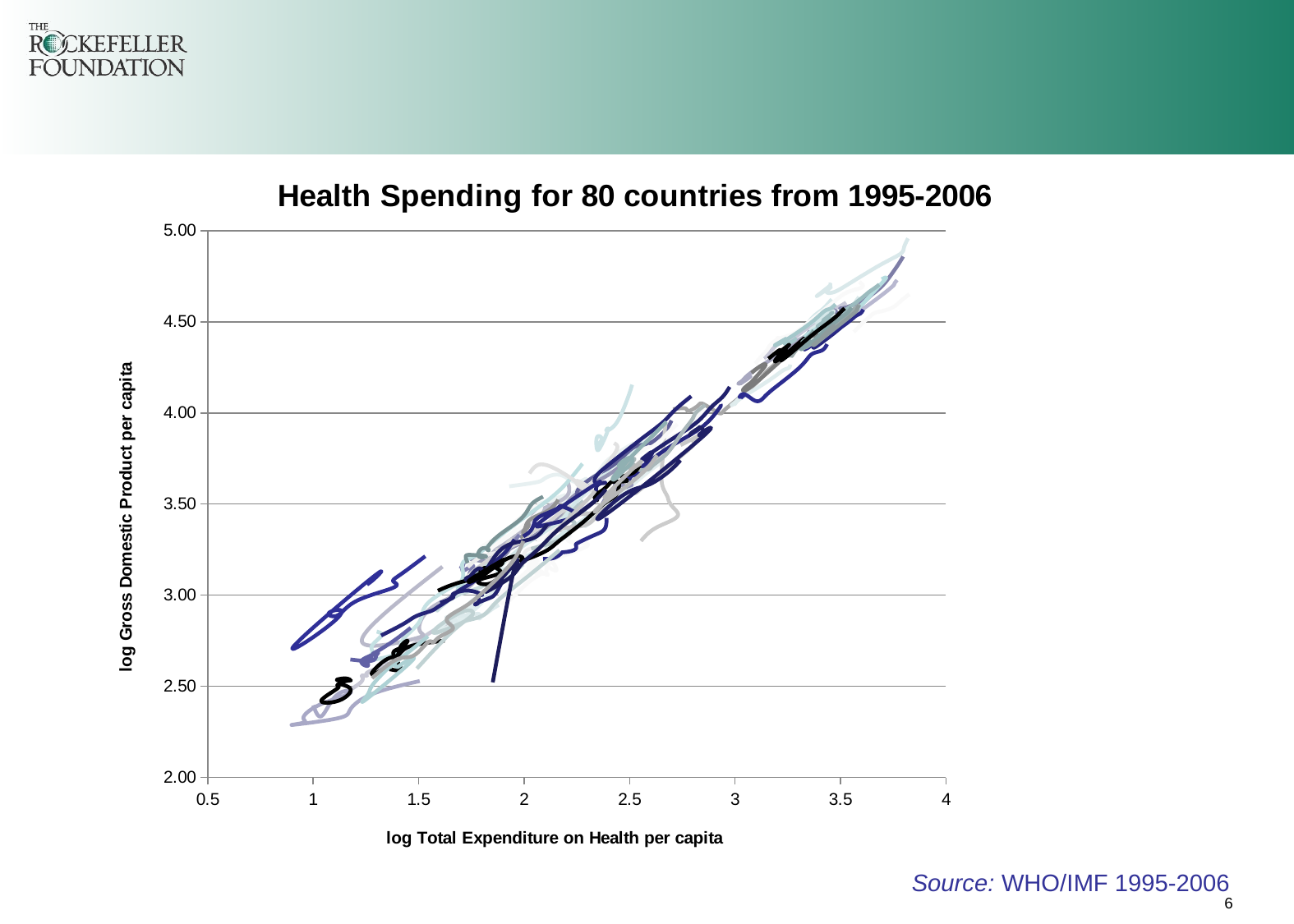
What is the lowest value shown on the y axis? 2.00 What is the title of the chart? Health Spending for 80 countries from 1995-2006 What kind of chart is shown on the slide? line chart How many countries does the chart cover, according to its title? 80 What period of years does the chart cover, according to its title? 1995-2006 What is the highest value shown on the y axis? 5.00 What is the highest value shown on the x axis? 4 As log Total Expenditure on Health per capita increases along the x axis, do the values of log Gross Domestic Product per capita generally rise or fall? rise What is the label of the x axis? log Total Expenditure on Health per capita